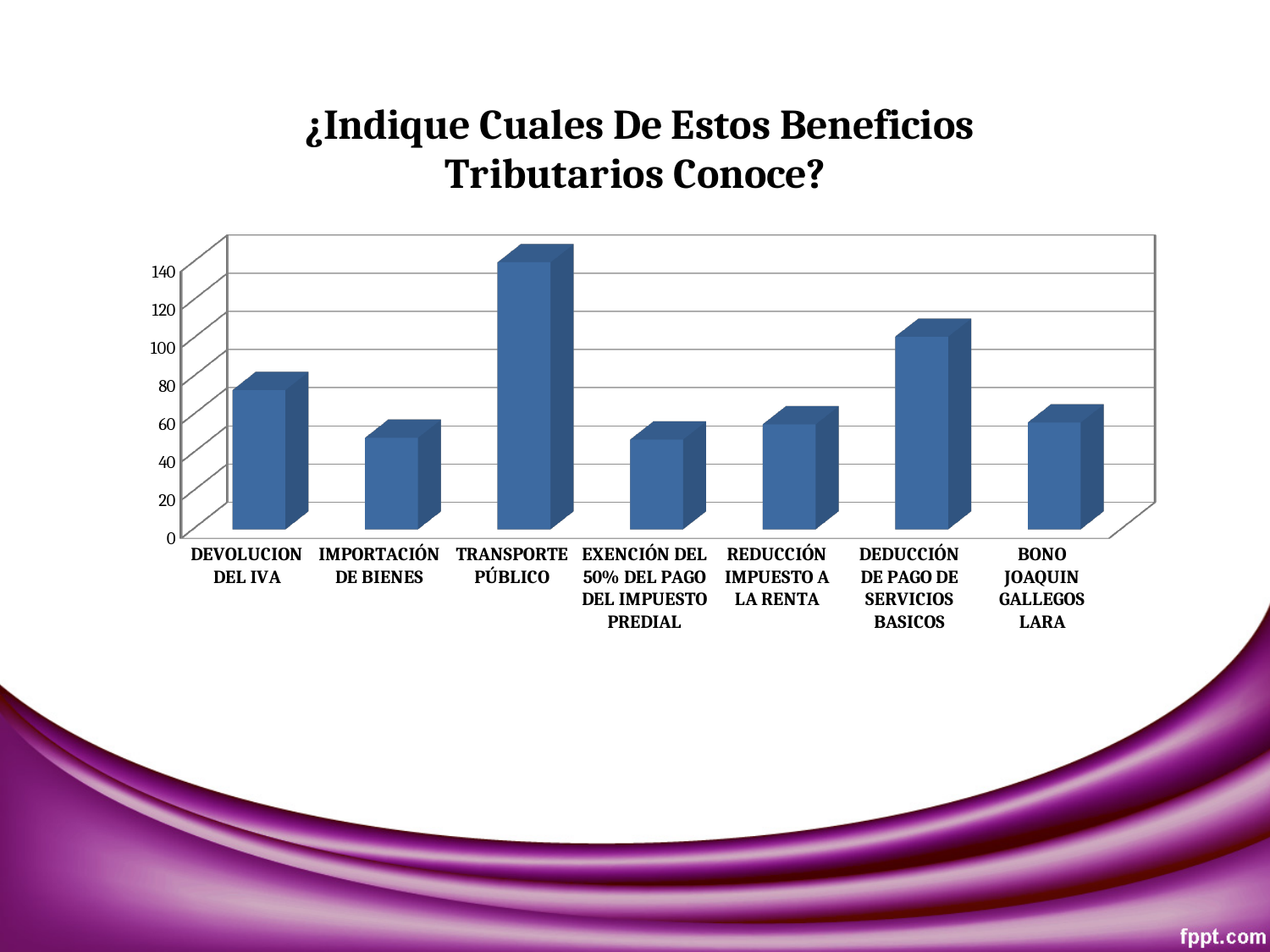
Which is larger, the value for DEVOLUCION DEL IVA or the value for IMPORTACIÓN DE BIENES? DEVOLUCION DEL IVA Is the value for TRANSPORTE PÚBLICO greater or less than 120? greater Which is larger, the value for DEDUCCIÓN DE PAGO DE SERVICIOS BASICOS or the value for BONO JOAQUIN GALLEGOS LARA? DEDUCCIÓN DE PAGO DE SERVICIOS BASICOS Which category has the highest value in the chart? TRANSPORTE PÚBLICO Is the value for IMPORTACIÓN DE BIENES greater or less than 80? less Is the value for EXENCIÓN DEL 50% DEL PAGO DEL IMPUESTO PREDIAL greater or less than 80? less What kind of chart is shown on the slide? bar chart How many benefit categories are shown on the x axis of the chart? 7 What is the title of the chart? ¿Indique Cuales De Estos Beneficios Tributarios Conoce?